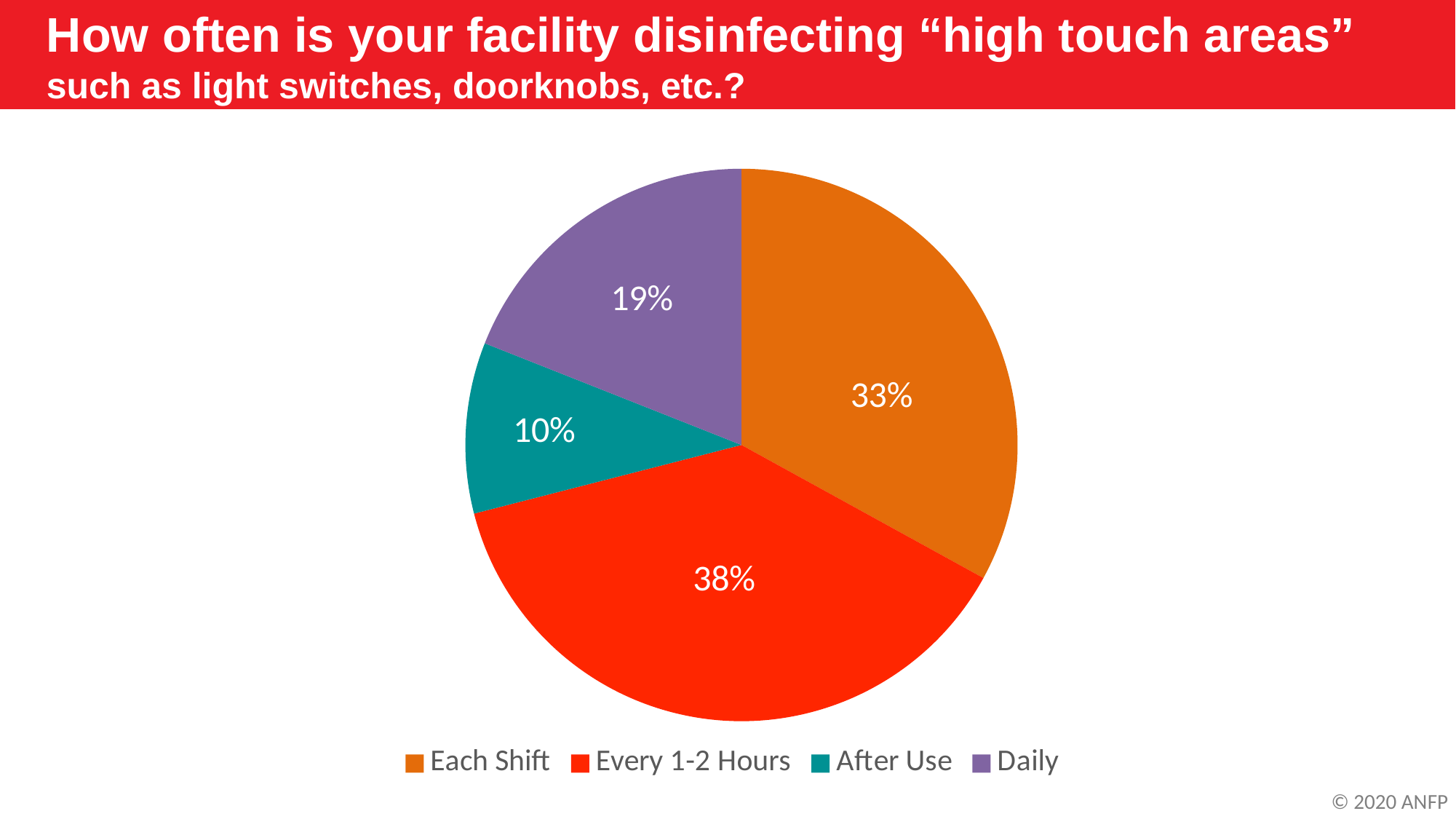
Which response has the smallest share of the pie? After Use What is the difference in percentage points between Every 1-2 Hours and Each Shift? 5 What percentage of facilities disinfect high touch areas daily? 19% Which is larger, the share for Daily or the share for After Use? Daily What is the difference in percentage points between Daily and After Use? 9 What kind of chart is shown on the slide? Pie chart What colour is the slice for Every 1-2 Hours? Red What percentage of facilities disinfect high touch areas each shift? 33% What percentage of facilities disinfect high touch areas every 1-2 hours? 38% What percentage of facilities disinfect high touch areas after use? 10% How many categories does the pie chart show? 4 Which response has the largest share of the pie? Every 1-2 Hours